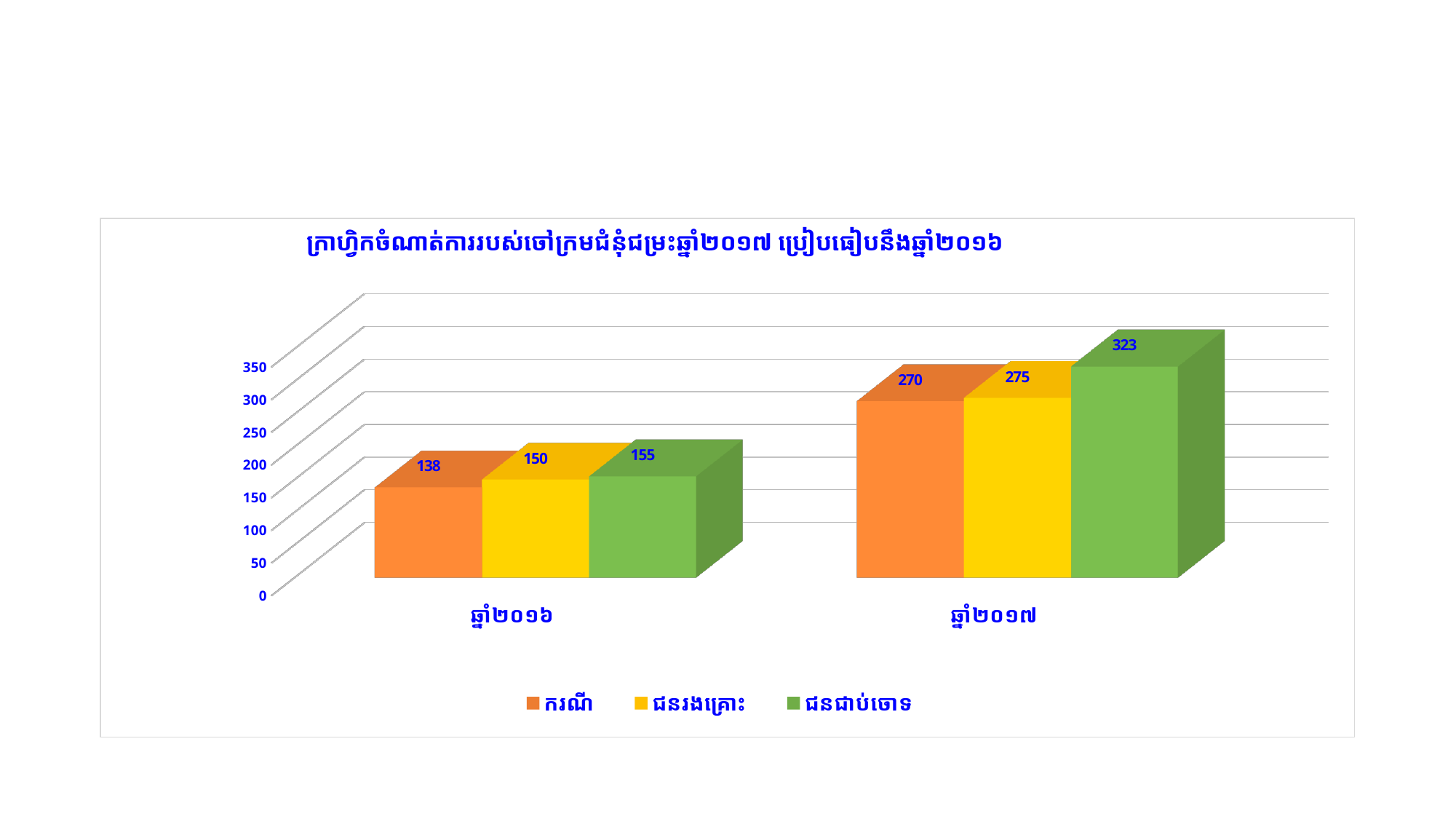
What is the value of ករណី for ឆ្នាំ២០១៦? 138 Do the values for ជនជាប់ចោទ rise or fall from ឆ្នាំ២០១៦ to ឆ្នាំ២០១៧? rise How many series does the legend list? 3 What is the value of ជនជាប់ចោទ for ឆ្នាំ២០១៧? 323 Which is larger: ជនជាប់ចោទ for ឆ្នាំ២០១៦ or ករណី for ឆ្នាំ២០១៧? ករណី for ឆ្នាំ២០១៧ Which series has the lowest value for ឆ្នាំ២០១៦? ករណី Which series has the highest value for ឆ្នាំ២០១៧? ជនជាប់ចោទ What type of chart is shown on the slide? bar chart What is the difference between the ករណី values for ឆ្នាំ២០១៧ and ឆ្នាំ២០១៦? 132 What is the value of ជនរងគ្រោះ for ឆ្នាំ២០១៦? 150 What is the value of ជនរងគ្រោះ for ឆ្នាំ២០១៧? 275 How many categories are shown on the x axis? 2